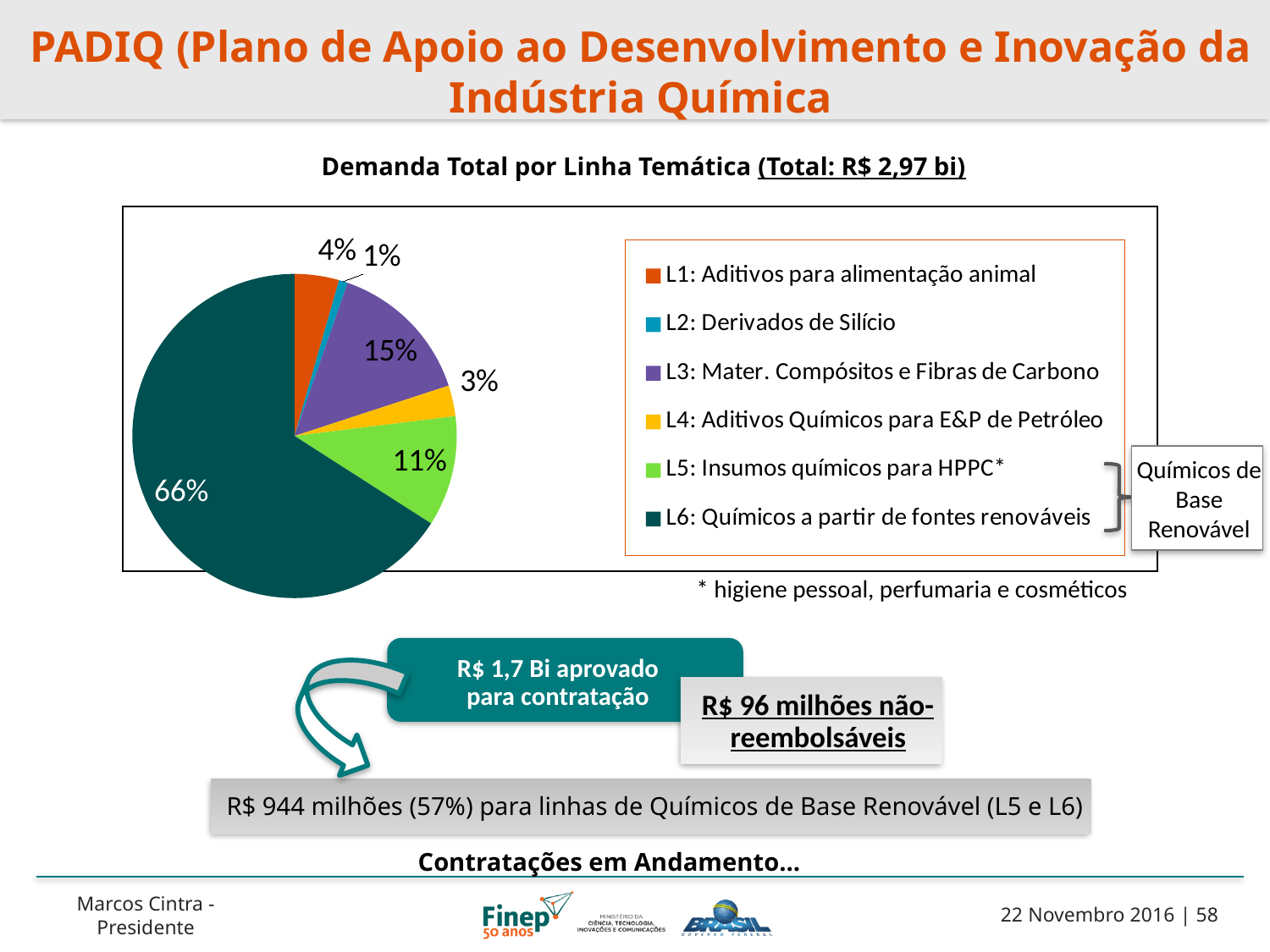
How many thematic lines does the legend list? 6 Which thematic line has the smallest share of the pie? L2: Derivados de Silício Which thematic line has the largest share of the pie? L6: Químicos a partir de fontes renováveis What is the difference in percentage points between the shares of L3 and L5? 4 What share of the pie does L1: Aditivos para alimentação animal represent? 4% What is the title of the chart? Demanda Total por Linha Temática (Total: R$ 2,97 bi) Which has a larger share, L1: Aditivos para alimentação animal or L4: Aditivos Químicos para E&P de Petróleo? L1: Aditivos para alimentação animal What share of the pie does L5: Insumos químicos para HPPC represent? 11% What kind of chart is shown on the slide? pie chart What share of the pie does L3: Mater. Compósitos e Fibras de Carbono represent? 15%